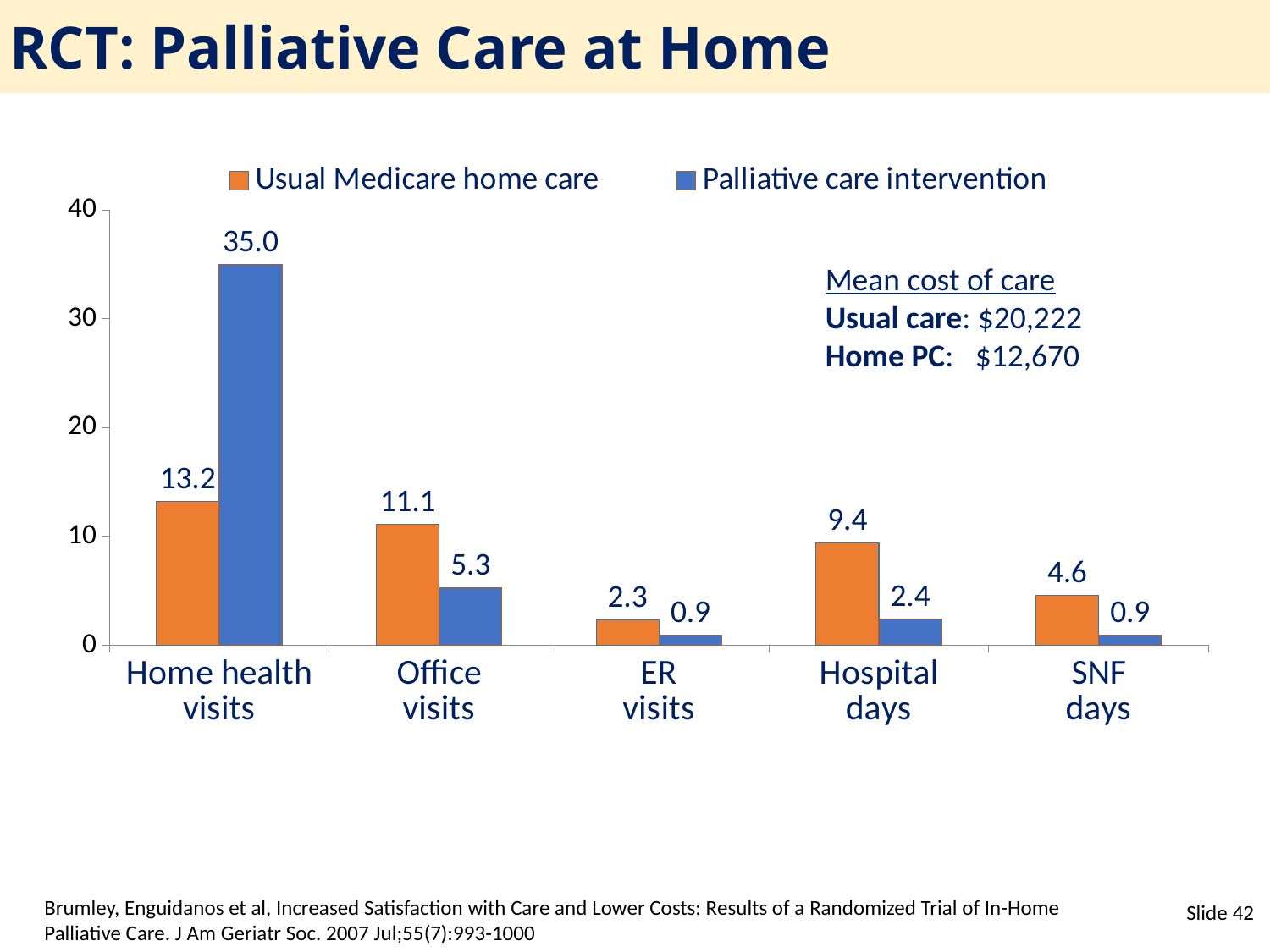
What colour are the bars for the Palliative care intervention series? Blue Which category has the highest value in the Usual Medicare home care series? Home health visits What is the value for Home health visits in the Palliative care intervention series? 35.0 Which category has the lowest value in the Usual Medicare home care series? ER visits What is the difference between the Palliative care intervention and Usual Medicare home care values for Home health visits? 21.8 For Office visits, which series has the larger value: Usual Medicare home care or Palliative care intervention? Usual Medicare home care What is the value for Office visits in the Usual Medicare home care series? 11.1 How many categories are shown on the x axis? 5 How many series does the legend list? 2 What is the value for Hospital days in the Palliative care intervention series? 2.4 What is the difference between the Usual Medicare home care and Palliative care intervention values for Hospital days? 7.0 What kind of chart is shown on the slide? Bar chart